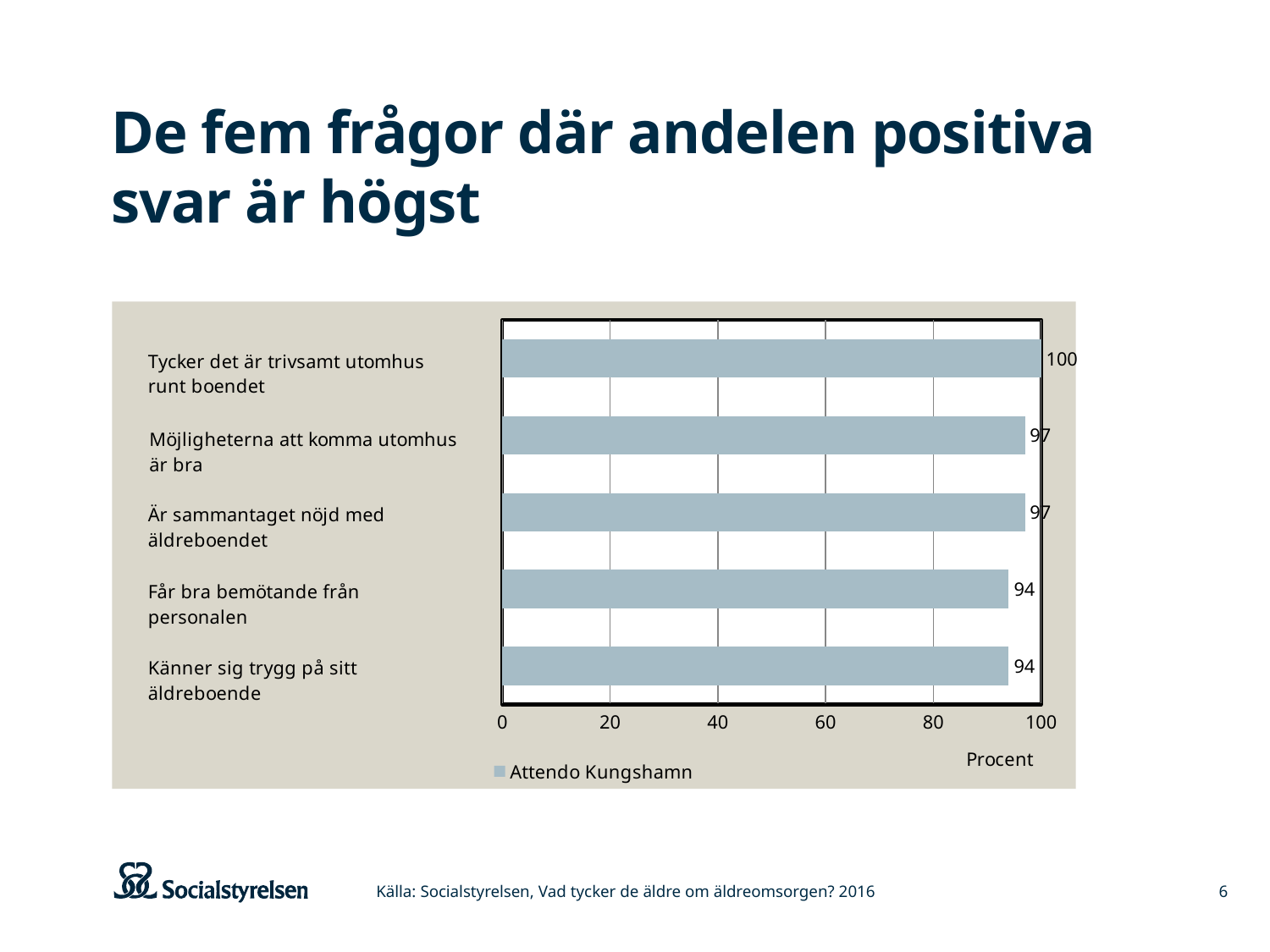
What kind of chart is shown on the slide? Bar chart What is the difference between the value for "Möjligheterna att komma utomhus är bra" and the value for "Får bra bemötande från personalen"? 3 How many series does the legend list? 1 What is the value for "Tycker det är trivsamt utomhus runt boendet"? 100 Which is larger: the value for "Är sammantaget nöjd med äldreboendet" or the value for "Känner sig trygg på sitt äldreboende"? Är sammantaget nöjd med äldreboendet Which category has the highest value? Tycker det är trivsamt utomhus runt boendet What is the value for "Känner sig trygg på sitt äldreboende"? 94 What is the difference between the value for "Tycker det är trivsamt utomhus runt boendet" and the value for "Är sammantaget nöjd med äldreboendet"? 3 What is the value for "Får bra bemötande från personalen"? 94 What is the value for "Möjligheterna att komma utomhus är bra"? 97 What series name is shown in the legend? Attendo Kungshamn How many categories are shown in the chart? 5